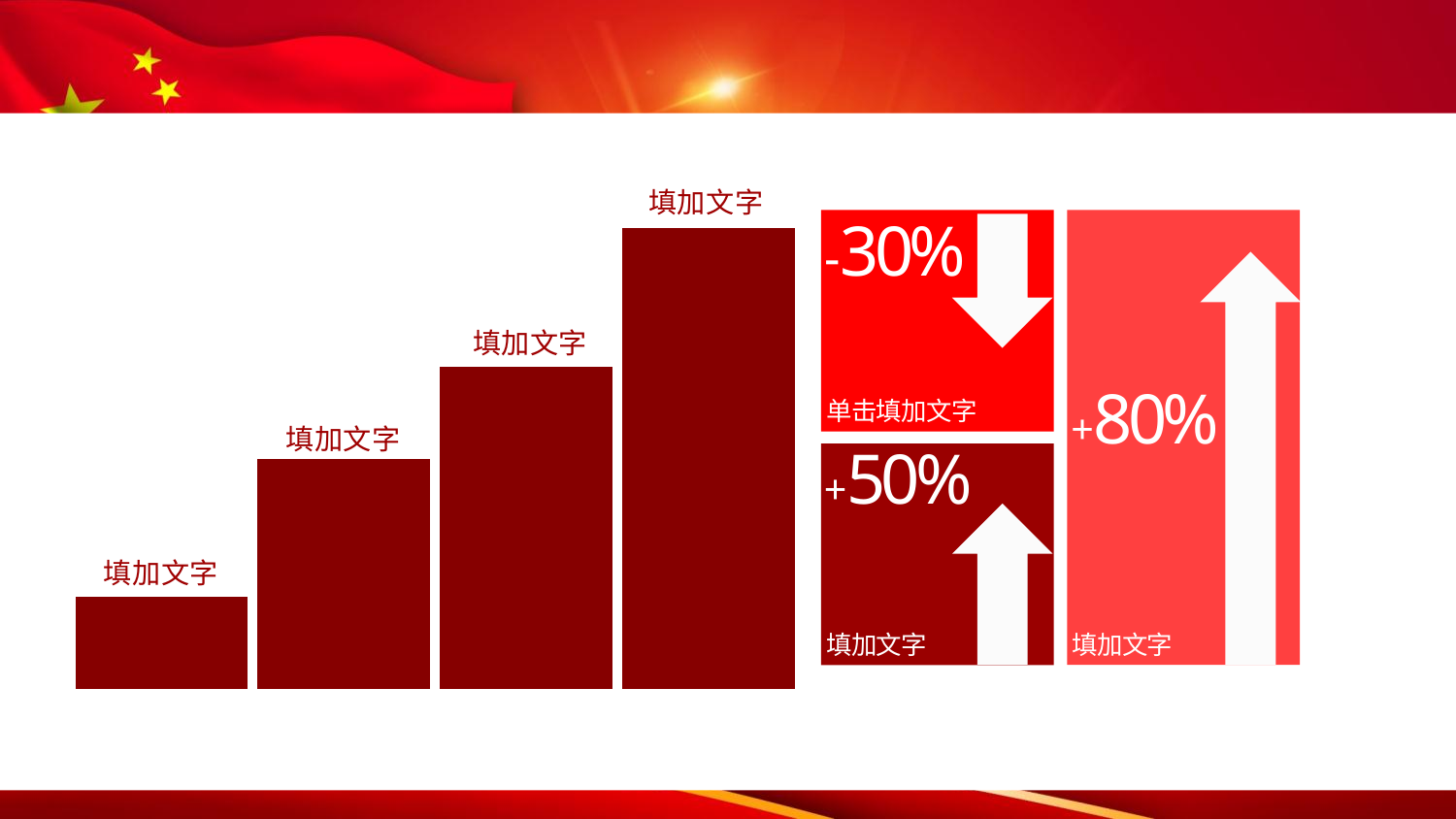
What kind of chart is shown on the left side of the slide? bar chart Which direction does the arrow in the -30% box point? downward Do the bars in the bar chart rise or fall from left to right? rise What percentage is shown in the tall light-red box on the far right? +80% Which bar in the bar chart is the tallest? the fourth (rightmost) bar What percentage is shown in the bright red box with the downward arrow? -30% How many bars does the bar chart on the left contain? 4 In the bar chart, is the second bar from the left taller or shorter than the third bar? shorter Which bar in the bar chart is the shortest? the first (leftmost) bar What percentage is shown in the dark red box with the upward arrow? +50% How many percentage boxes are shown to the right of the bar chart? 3 What label text appears above each bar in the bar chart? 填加文字